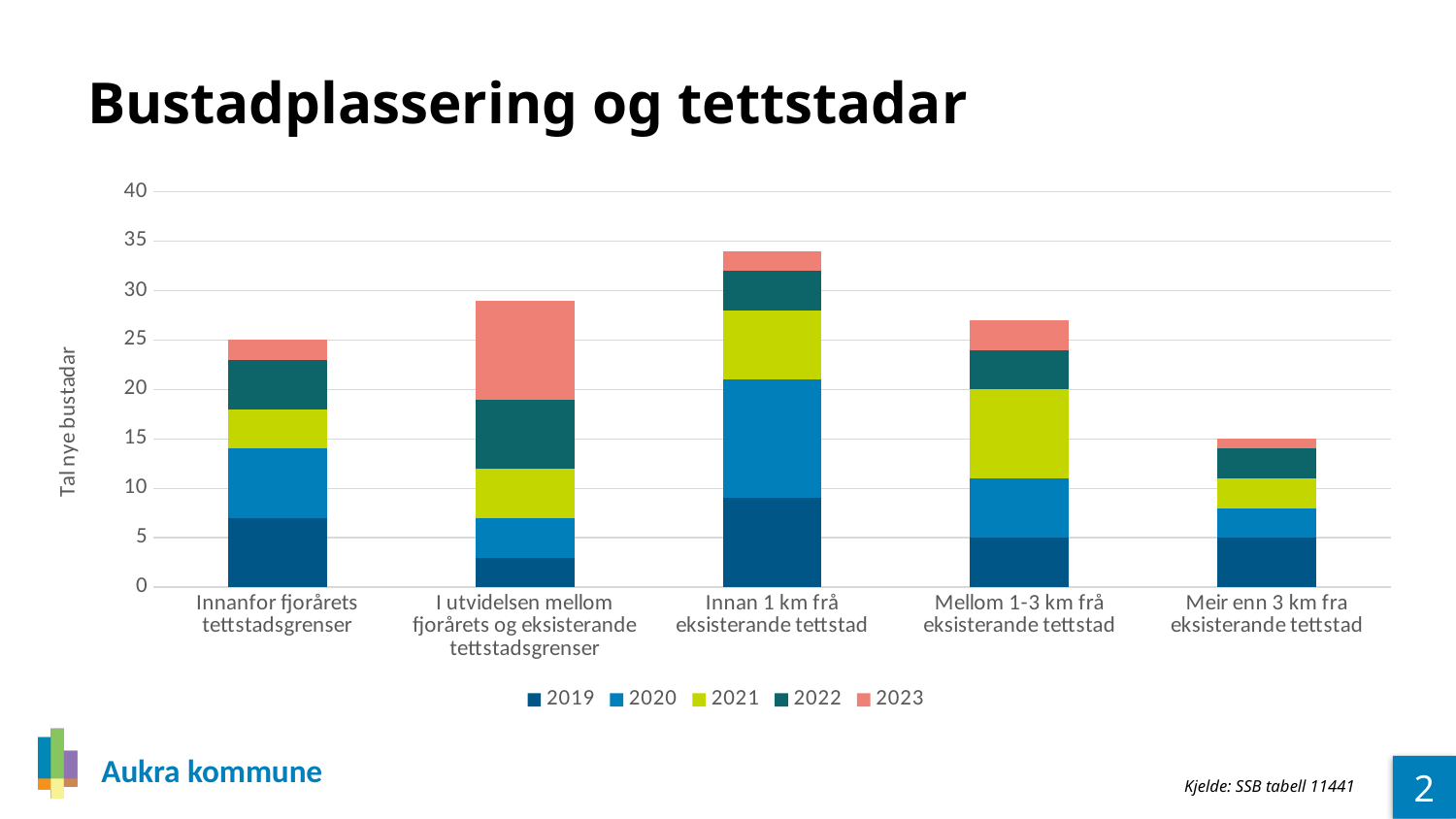
Is the total stacked value for 'Innan 1 km frå eksisterande tettstad' greater or less than 30? greater How many series does the legend list? 5 Is the total stacked value for 'I utvidelsen mellom fjorårets og eksisterande tettstadsgrenser' greater or less than 25? greater What is the label on the y axis? Tal nye bustadar How many categories are shown along the x axis? 5 What kind of chart is shown on the slide? Stacked bar chart Is the total stacked value for 'Mellom 1-3 km frå eksisterande tettstad' greater or less than 30? less Which category has the tallest stacked bar in total? Innan 1 km frå eksisterande tettstad Which is larger in total: the bar for 'Innanfor fjorårets tettstadsgrenser' or the bar for 'Meir enn 3 km fra eksisterande tettstad'? Innanfor fjorårets tettstadsgrenser What is the total stacked value for 'Meir enn 3 km fra eksisterande tettstad'? 15 Which category has the shortest stacked bar in total? Meir enn 3 km fra eksisterande tettstad What is the title of the chart? Bustadplassering og tettstadar